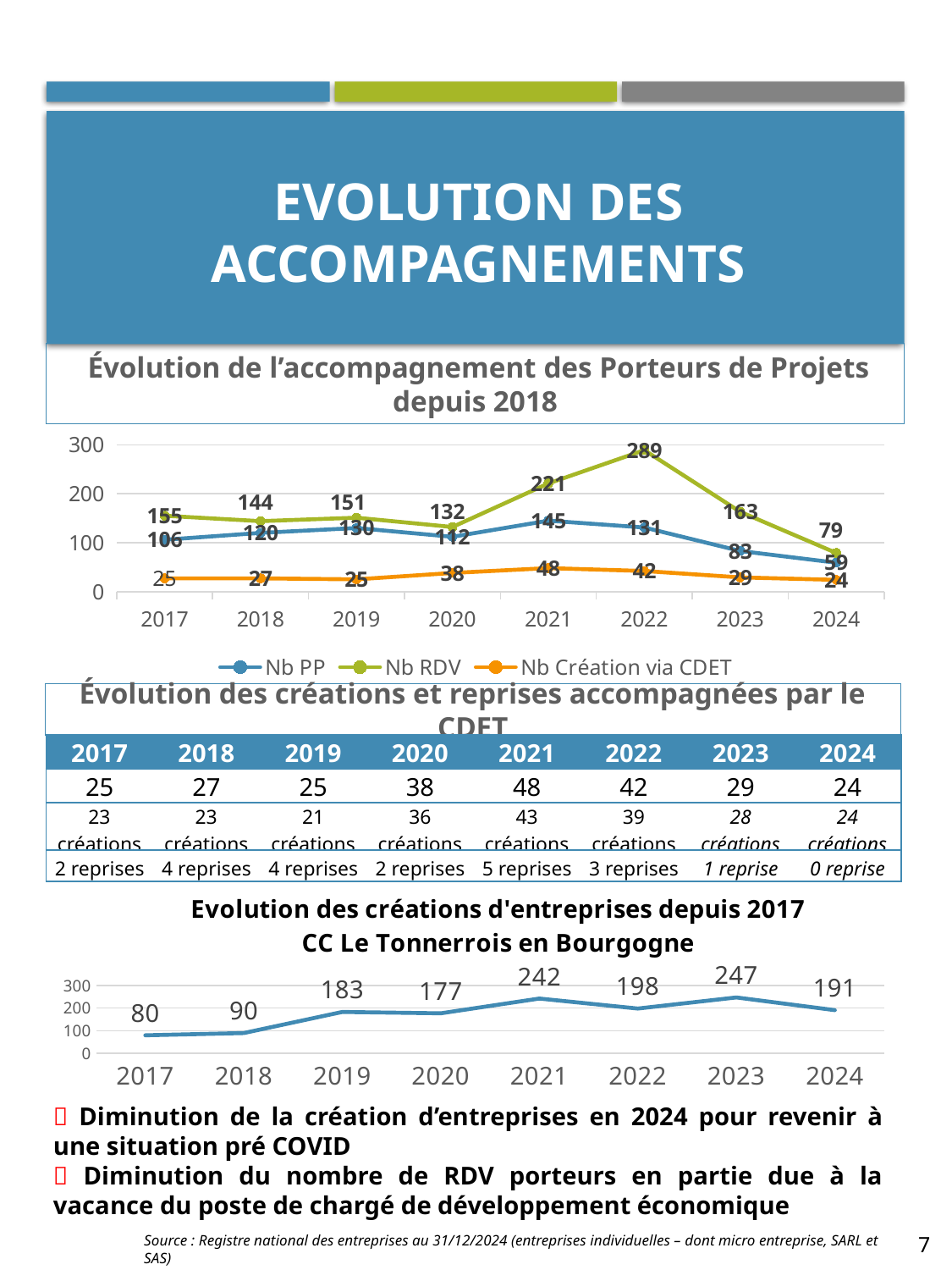
In the top chart 'Évolution de l'accompagnement des Porteurs de Projets depuis 2018', in which year is Nb PP lowest? 2024 In the top chart 'Évolution de l'accompagnement des Porteurs de Projets depuis 2018', what is the Nb RDV value for 2022? 289 In the bottom chart 'Evolution des créations d'entreprises depuis 2017 CC Le Tonnerrois en Bourgogne', how many years are plotted on the x axis? 8 In the top chart 'Évolution de l'accompagnement des Porteurs de Projets depuis 2018', how many series does the legend list? 3 In the bottom chart 'Evolution des créations d'entreprises depuis 2017 CC Le Tonnerrois en Bourgogne', which year has the lowest value? 2017 In the top chart 'Évolution de l'accompagnement des Porteurs de Projets depuis 2018', in which year is Nb RDV highest? 2022 In the bottom chart 'Evolution des créations d'entreprises depuis 2017 CC Le Tonnerrois en Bourgogne', what is the difference between the 2023 and 2024 values? 56 In the top chart 'Évolution de l'accompagnement des Porteurs de Projets depuis 2018', what is the Nb PP value for 2021? 145 In the top chart 'Évolution de l'accompagnement des Porteurs de Projets depuis 2018', which is larger in 2020: Nb PP or Nb RDV? Nb RDV What kind of chart is the bottom chart 'Evolution des créations d'entreprises depuis 2017 CC Le Tonnerrois en Bourgogne'? Line chart In the bottom chart 'Evolution des créations d'entreprises depuis 2017 CC Le Tonnerrois en Bourgogne', what is the value for 2023? 247 In the top chart 'Évolution de l'accompagnement des Porteurs de Projets depuis 2018', what is the difference between Nb RDV in 2022 and Nb RDV in 2023? 126